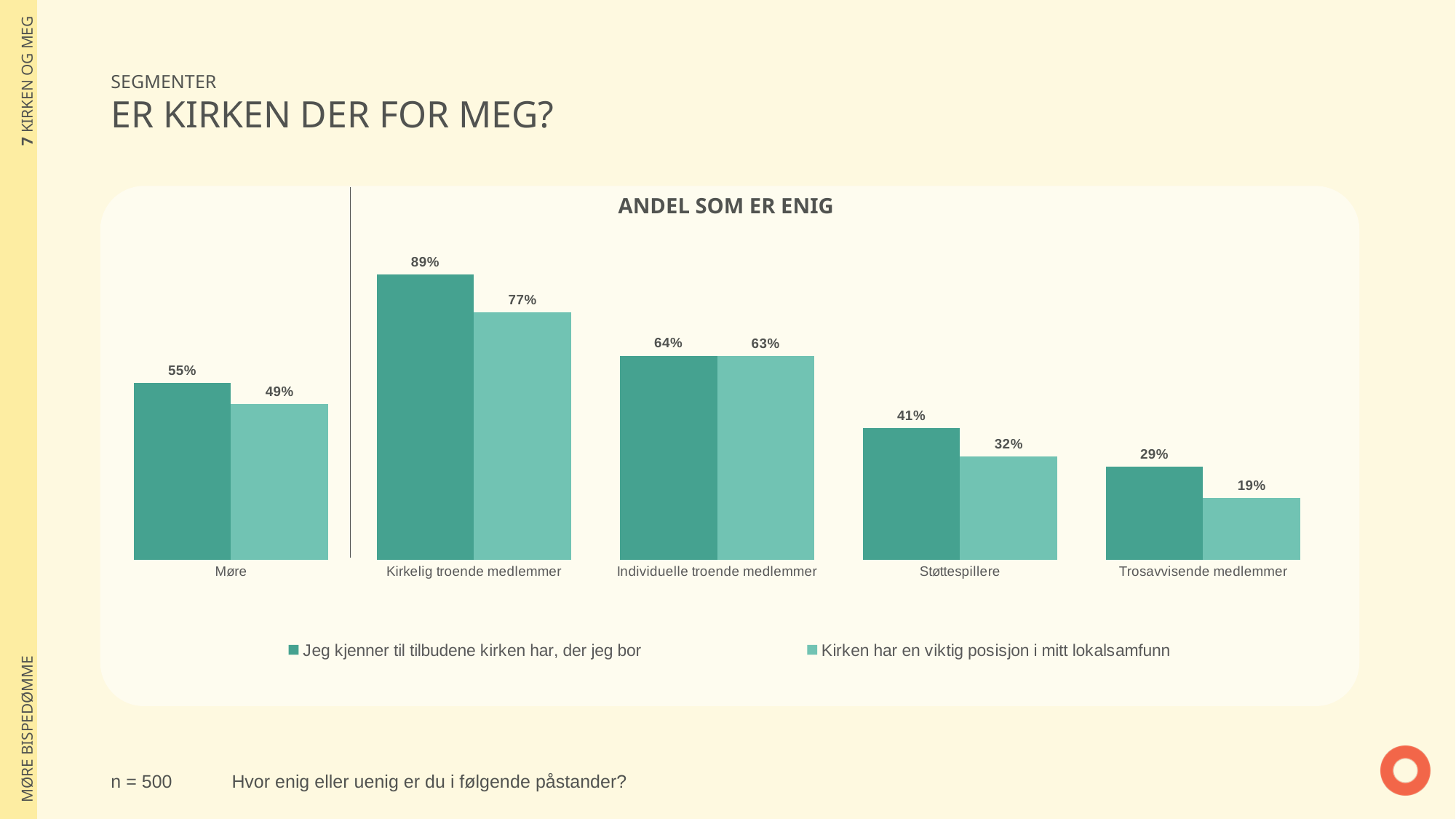
Which category has the lowest value in the series 'Kirken har en viktig posisjon i mitt lokalsamfunn'? Trosavvisende medlemmer What is the difference between the two series values for Kirkelig troende medlemmer? 12 percentage points What is the value for Møre in the series 'Kirken har en viktig posisjon i mitt lokalsamfunn'? 49% How many categories are shown on the x axis of the chart? 5 Which category has the highest value in the series 'Jeg kjenner til tilbudene kirken har, der jeg bor'? Kirkelig troende medlemmer What is the value for Støttespillere in the series 'Kirken har en viktig posisjon i mitt lokalsamfunn'? 32% Which is larger for Trosavvisende medlemmer: 'Jeg kjenner til tilbudene kirken har, der jeg bor' or 'Kirken har en viktig posisjon i mitt lokalsamfunn'? Jeg kjenner til tilbudene kirken har, der jeg bor What kind of chart is shown on the slide? Bar chart How many series does the legend list? 2 What is the value for Kirkelig troende medlemmer in the series 'Jeg kjenner til tilbudene kirken har, der jeg bor'? 89% What is the difference between the values for Individuelle troende medlemmer and Støttespillere in the series 'Jeg kjenner til tilbudene kirken har, der jeg bor'? 23 percentage points What is the title of the chart? ANDEL SOM ER ENIG